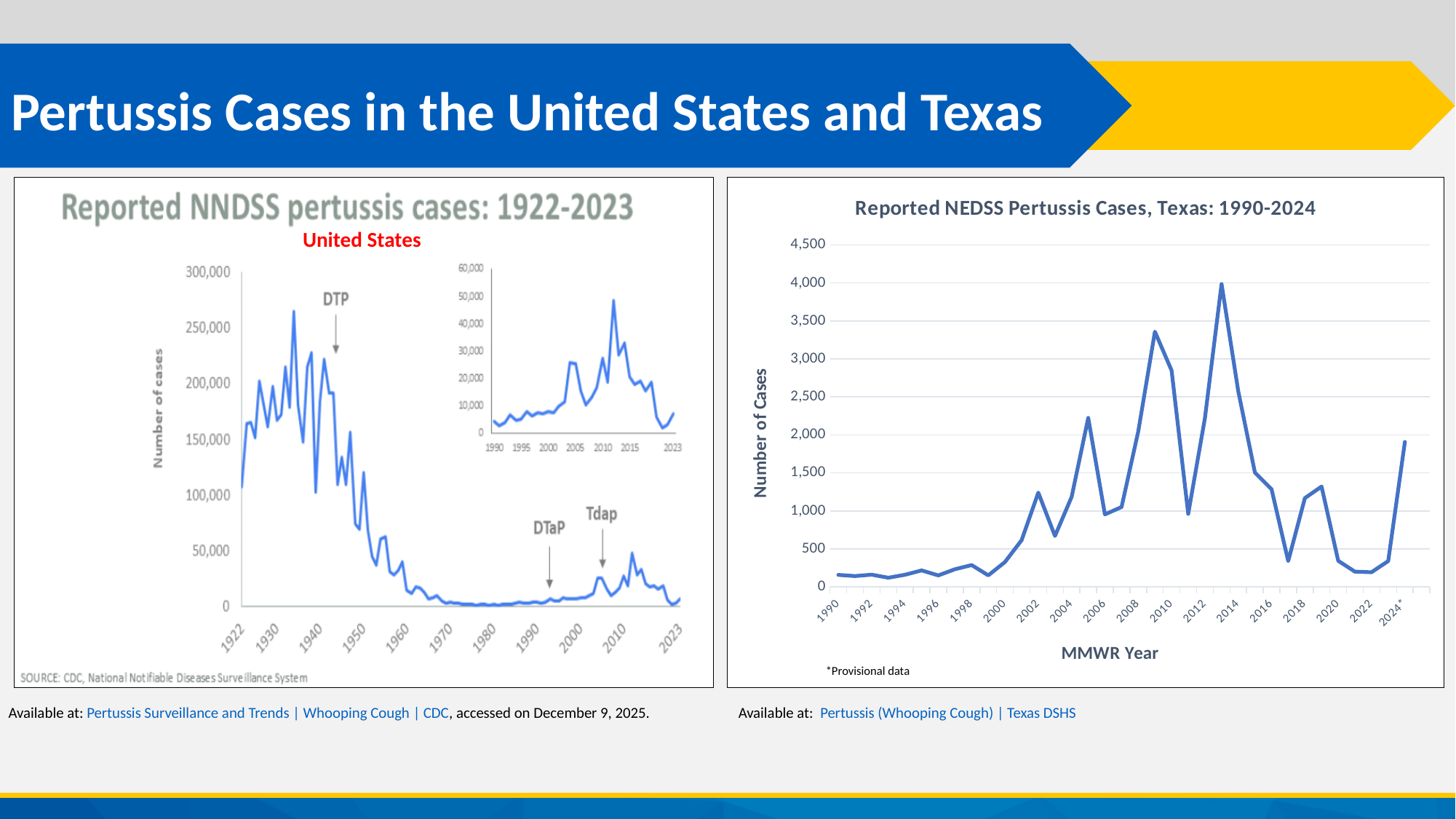
In the Texas chart on the right, is the highest value on the line greater or less than 3,500? greater In the Texas chart on the right, is the value for 2002 greater or less than 1,000? greater In the United States chart on the left, do the values generally rise or fall between 1940 and 1970? fall In the Texas chart on the right, is the value for 2024* greater or less than 1,500? greater Which three vaccines are annotated with arrows on the United States chart on the left? DTP, DTaP, Tdap In the Texas chart on the right, do the values rise or fall between 2022 and 2024*? rise What kind of chart is the 'Reported NNDSS pertussis cases: 1922-2023' chart on the left? Line chart What is the x-axis label of the Texas chart on the right? MMWR Year What kind of chart is the 'Reported NEDSS Pertussis Cases, Texas: 1990-2024' chart on the right? Line chart